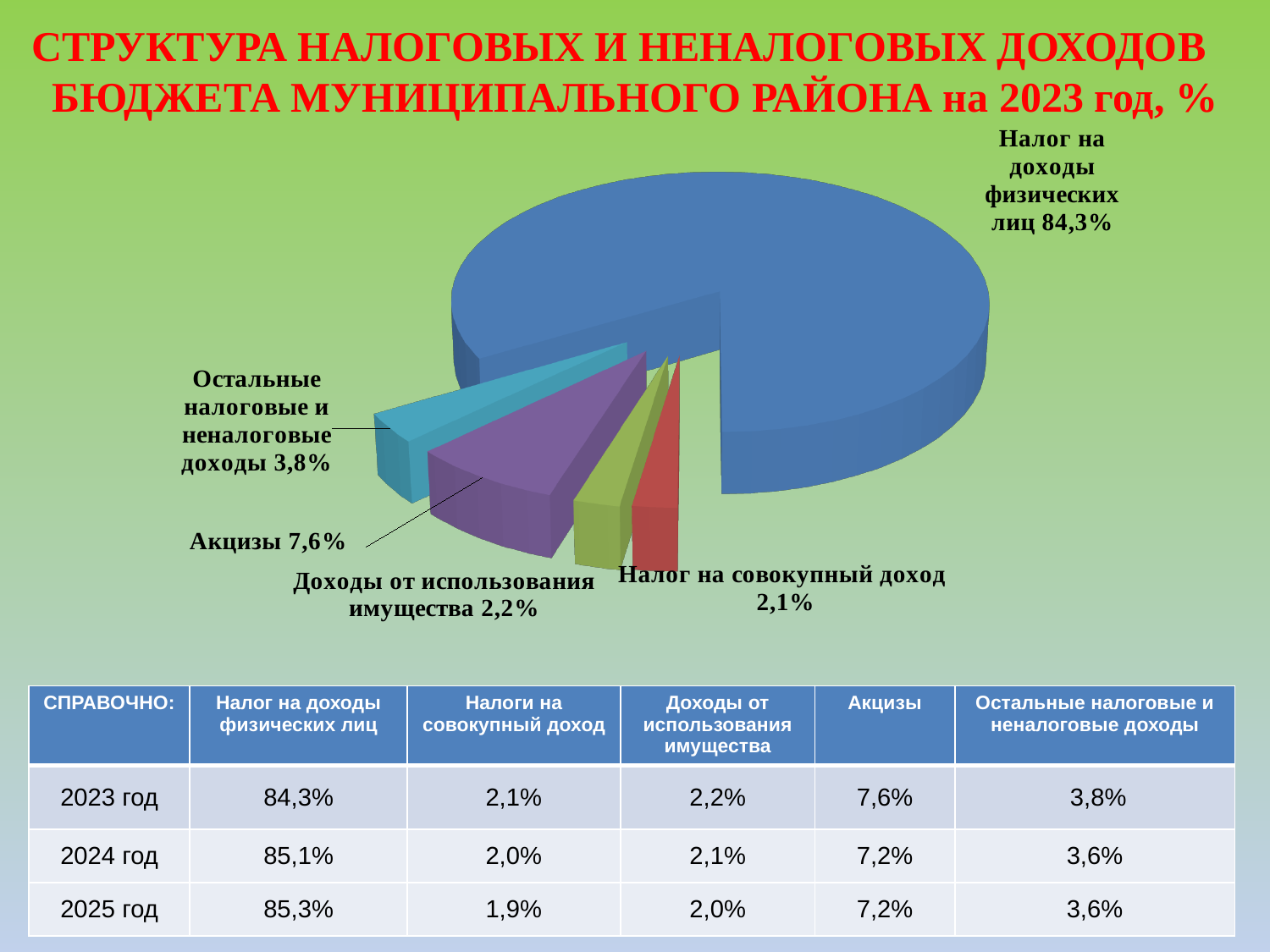
What is the value shown for Акцизы in the pie chart? 7,6% Which slice of the pie chart is the smallest? Налог на совокупный доход What is the value shown for Доходы от использования имущества in the pie chart? 2,2% What is the difference between the Акцизы slice and the Остальные налоговые и неналоговые доходы slice? 3,8% What share of the pie chart is Налог на доходы физических лиц? 84,3% What kind of chart is shown on the slide? pie chart Which is larger in the pie chart: Акцизы or Остальные налоговые и неналоговые доходы? Акцизы How many slices does the pie chart have? 5 What is the value shown for Остальные налоговые и неналоговые доходы in the pie chart? 3,8% What colour is the largest slice of the pie chart? blue What is the value shown for Налог на совокупный доход in the pie chart? 2,1% Which slice of the pie chart is the largest? Налог на доходы физических лиц